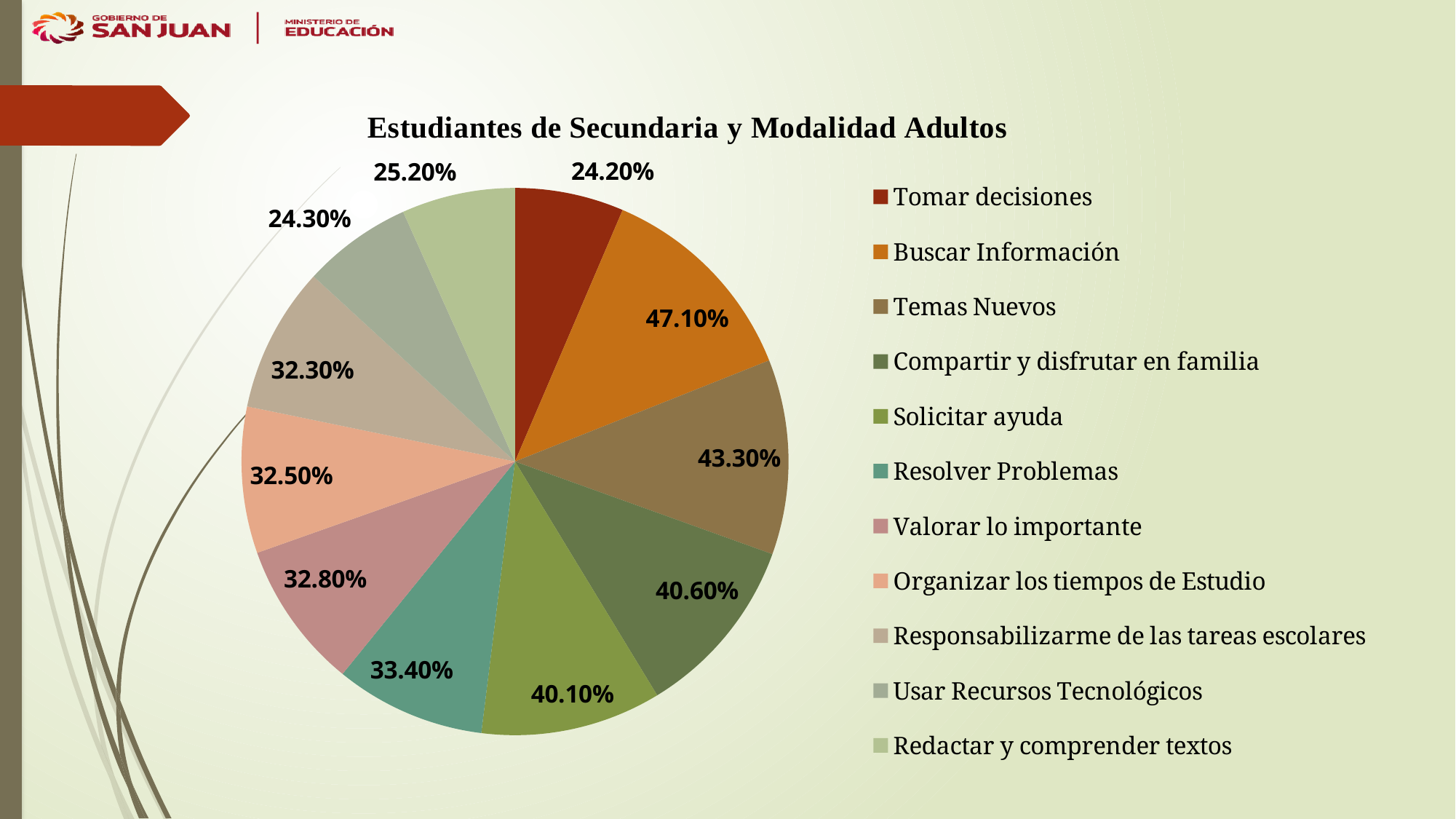
What is the value for Tomar decisiones? 24.20% What is the title of the chart? Estudiantes de Secundaria y Modalidad Adultos What is the value for Buscar Información? 47.10% What is the value for Redactar y comprender textos? 25.20% Which category has the highest value? Buscar Información How many entries does the legend list? 11 Which category has the lowest value? Tomar decisiones What is the value for Resolver Problemas? 33.40% How many categories are shown in the pie chart? 11 What is the difference between the values for Buscar Información and Temas Nuevos? 3.80% What type of chart is shown on the slide? Pie chart Which is larger, the value for Compartir y disfrutar en familia or the value for Solicitar ayuda? Compartir y disfrutar en familia